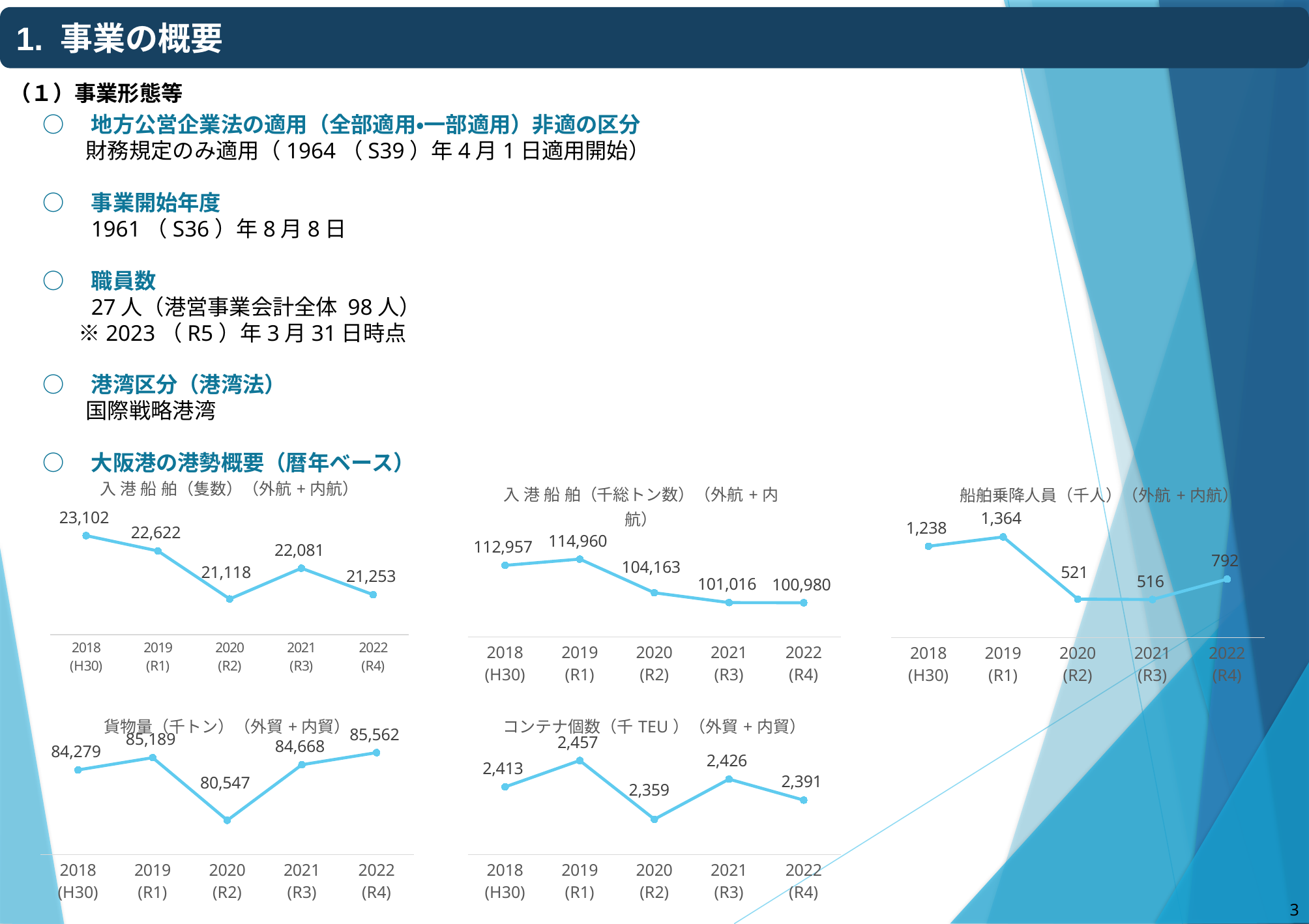
In the 入港船舶（千総トン数）（外航＋内航） chart, what is the value for 2022 (R4)? 100,980 What type of chart is the 貨物量（千トン）（外貿＋内貿） chart? Line chart In the 船舶乗降人員（千人）（外航＋内航） chart, what is the value for 2021 (R3)? 516 In the 入港船舶（隻数）（外航＋内航） chart, which year has the lowest value? 2020 (R2) In the 船舶乗降人員（千人）（外航＋内航） chart, which is larger, the value for 2018 (H30) or 2022 (R4)? 2018 (H30) In the 入港船舶（千総トン数）（外航＋内航） chart, what is the difference between the 2019 (R1) and 2020 (R2) values? 10,797 In the コンテナ個数（千TEU）（外貿＋内貿） chart, what is the value for 2021 (R3)? 2,426 In the 入港船舶（千総トン数）（外航＋内航） chart, which year has the highest value? 2019 (R1) In the 入港船舶（隻数）（外航＋内航） chart, what is the value for 2019 (R1)? 22,622 In the 貨物量（千トン）（外貿＋内貿） chart, which year has the highest value? 2022 (R4) In the コンテナ個数（千TEU）（外貿＋内貿） chart, how many data points are plotted? 5 In the 貨物量（千トン）（外貿＋内貿） chart, what is the value for 2020 (R2)? 80,547